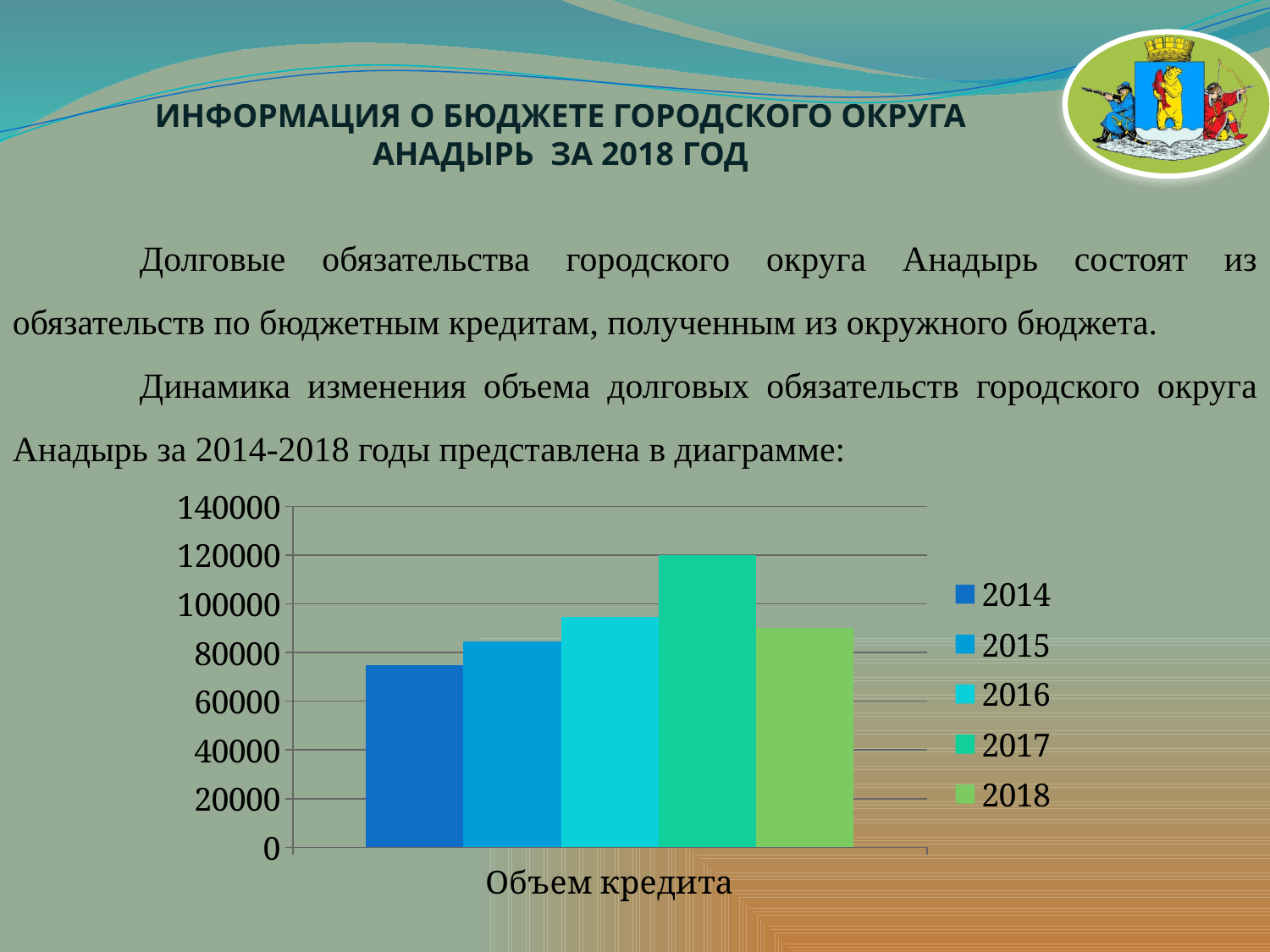
Is the value for 2018 greater or less than 100000? less What kind of chart is shown on the slide? bar chart What is the category label shown on the x axis of the chart? Объем кредита How many series does the chart legend list? 5 Is the value for 2017 greater or less than 100000? greater Which is larger in the chart, the value for 2017 or the value for 2018? 2017 How many categories are shown on the x axis of the chart? 1 Which is larger in the chart, the value for 2015 or the value for 2016? 2016 Which year has the lowest bar in the chart? 2014 Which year has the highest bar in the chart? 2017 Is the value for 2016 greater or less than 100000? less